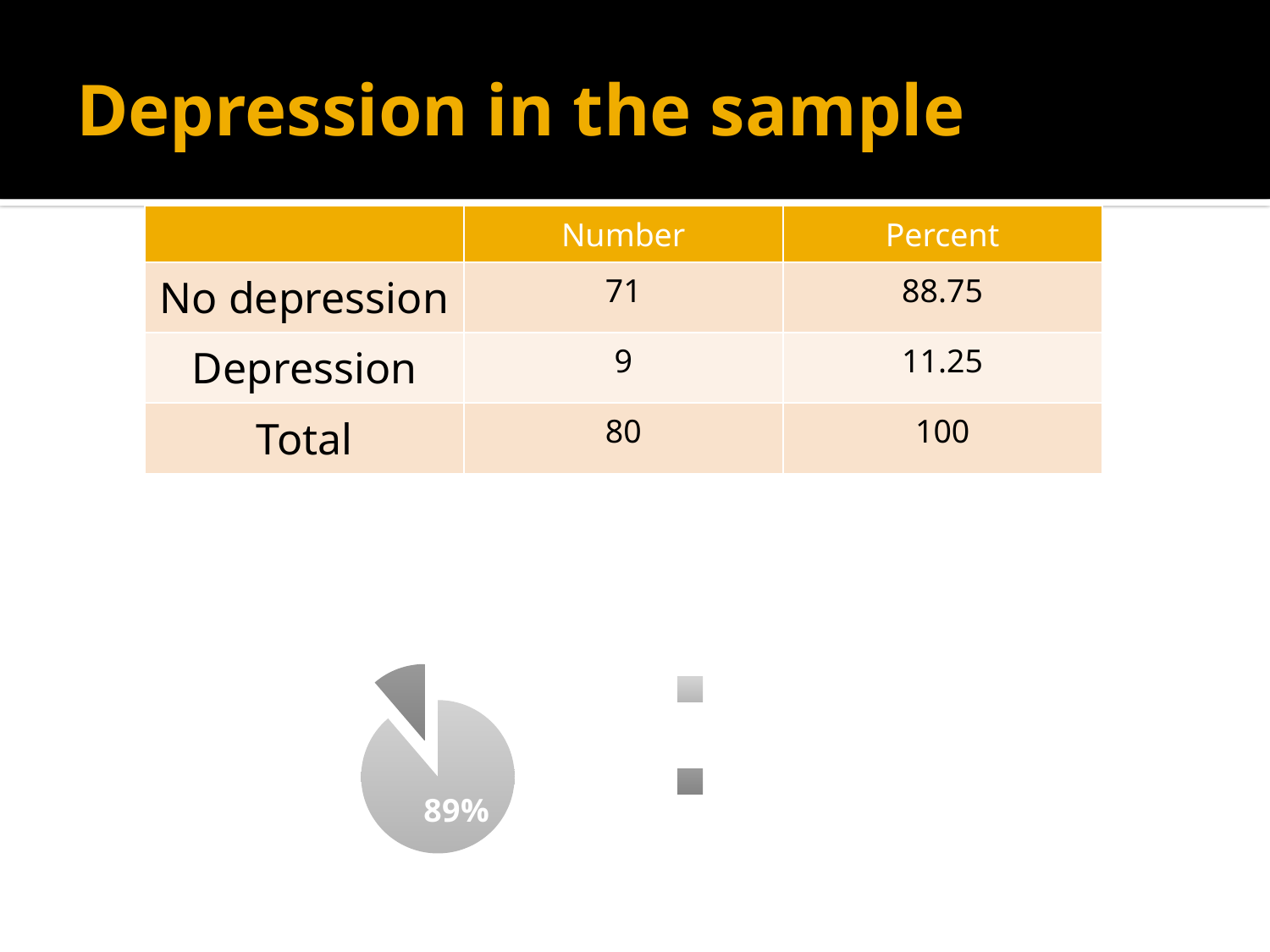
What percentage is printed on the large slice of the pie chart? 89% What colour is the large slice of the pie chart? light grey How many entries does the legend of the pie chart show? 2 How many slices does the pie chart have? 2 Is the small slice of the pie chart pulled out (exploded) from the rest of the pie? yes What share of the pie does the large grey slice represent? 89% Which slice of the pie chart is larger, the slice labelled 89% or the small exploded slice? the slice labelled 89% What kind of chart is shown at the bottom of the slide? pie chart